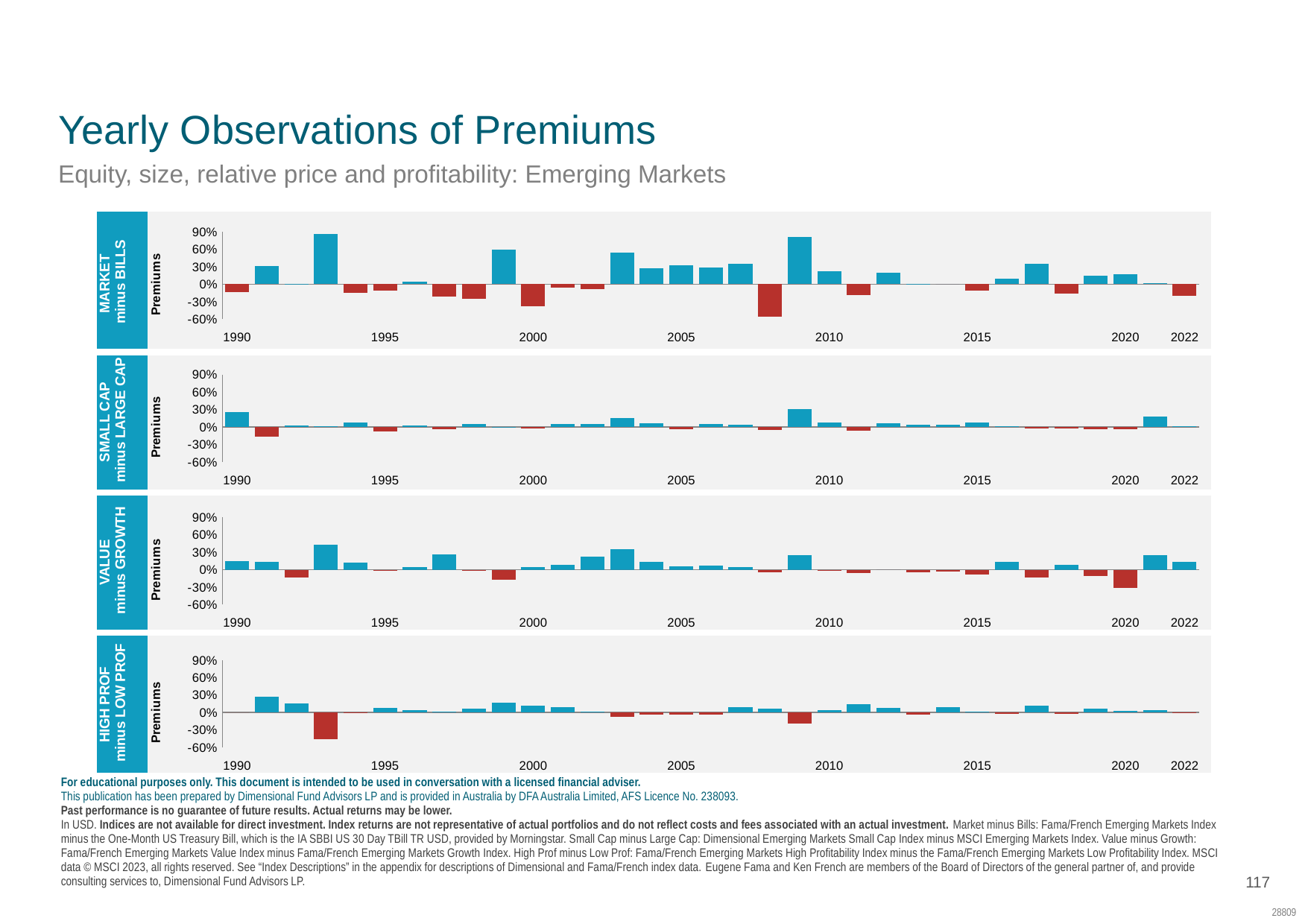
In the 'SMALL CAP minus LARGE CAP' chart, which year has the lowest premium? 1991 In the 'VALUE minus GROWTH' chart, which year has the lowest premium? 2020 In the 'HIGH PROF minus LOW PROF' chart, which year has the lowest premium? 1993 What kind of chart is used in the 'MARKET minus BILLS' panel? bar chart In the 'MARKET minus BILLS' chart, is the value for 1993 greater or less than 60%? greater In the 'MARKET minus BILLS' chart, which is larger, the value for 2008 or the value for 2009? 2009 How many chart panels are shown on the slide? 4 In the 'VALUE minus GROWTH' chart, which is larger, the value for 2020 or the value for 2021? 2021 In the 'HIGH PROF minus LOW PROF' chart, is the value for 1993 greater or less than -30%? less In the 'MARKET minus BILLS' chart, is the value for 2008 greater or less than -30%? less What is the label on the vertical axis of each chart panel? Premiums